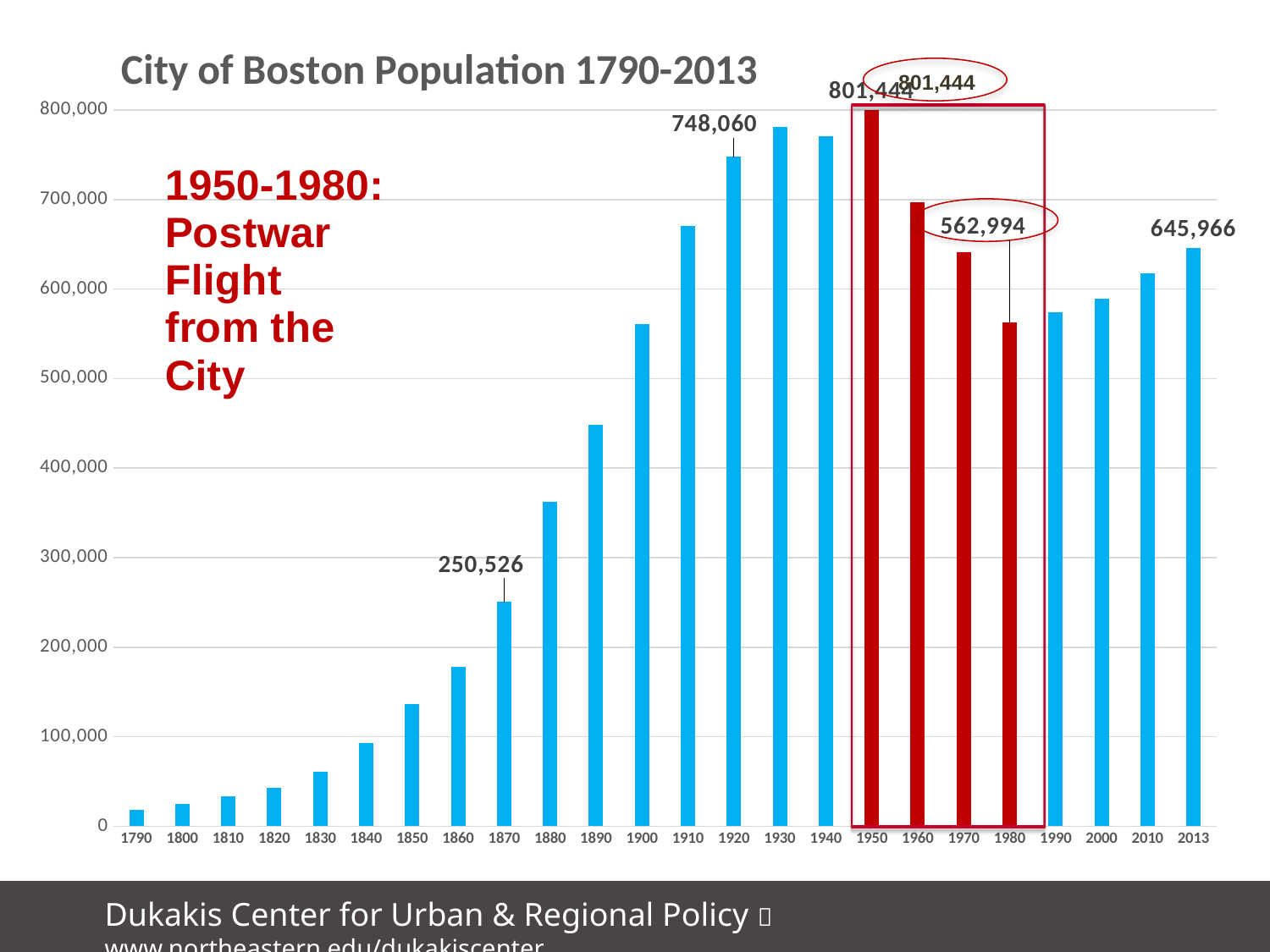
What is the population value labeled for 1870? 250,526 What is the population value labeled for 2013? 645,966 Do the values rise or fall from 1950 to 1980? fall How many years (bars) are shown on the x axis? 24 Which is larger, the population in 1920 or in 1870? 1920 Which year has the lowest population bar? 1790 Is the value for 1930 greater or less than 700,000? greater Is the value for 1840 greater or less than 100,000? less What is the population value shown for 1950? 801,444 What is the population value shown for 1980? 562,994 What is the difference between the 1950 population and the 1980 population? 238,450 Which year has the highest population bar? 1950